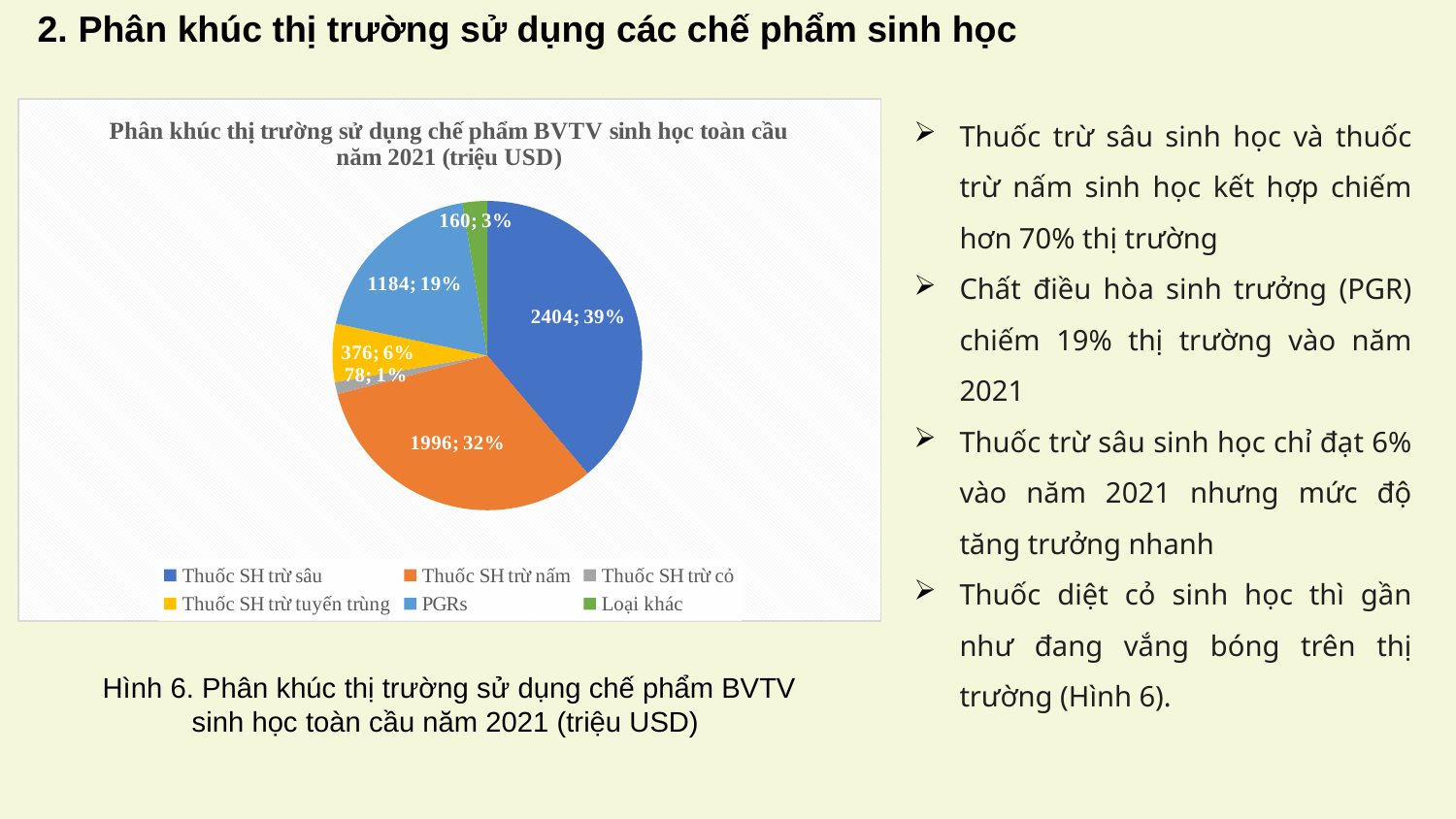
What share of the pie does Loại khác represent? 3% What is the difference between the values for Thuốc SH trừ sâu and Thuốc SH trừ nấm? 408 Which category has the smallest slice in the pie chart? Thuốc SH trừ cỏ What is the value for Thuốc SH trừ sâu in the pie chart? 2404 What is the value for Thuốc SH trừ cỏ in the pie chart? 78 What share of the pie does Thuốc SH trừ nấm represent? 32% Which is larger, the value for PGRs or the value for Thuốc SH trừ tuyến trùng? PGRs Which category has the largest slice in the pie chart? Thuốc SH trừ sâu How many categories does the pie chart have? 6 What is the title of the pie chart? Phân khúc thị trường sử dụng chế phẩm BVTV sinh học toàn cầu năm 2021 (triệu USD) What is the value for PGRs in the pie chart? 1184 What kind of chart is shown on the slide? Pie chart